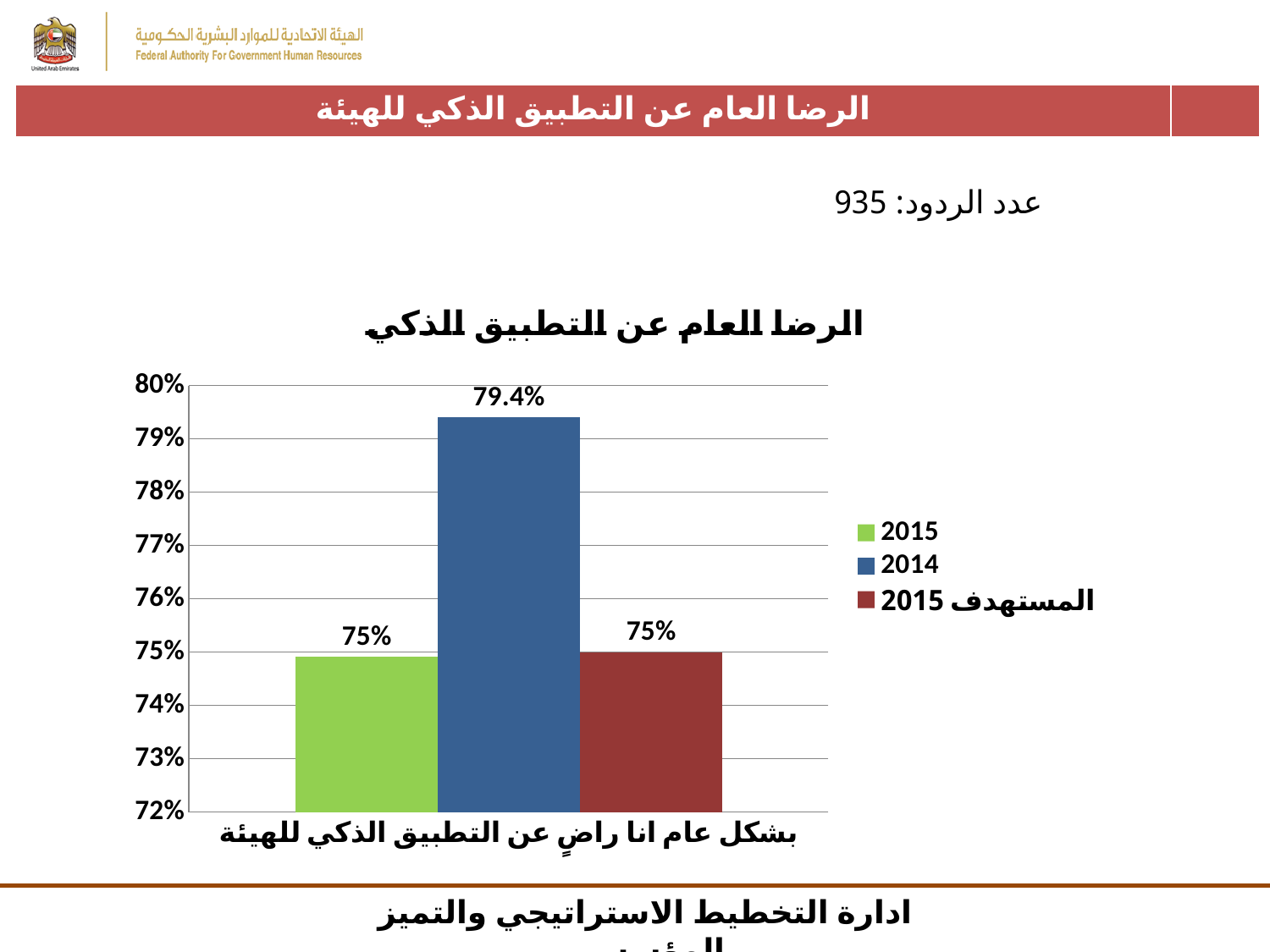
What kind of chart is shown on the slide? bar chart Which series has the highest value? 2014 What is the value for the المستهدف 2015 series? 75% Which is larger, the 2014 value or the المستهدف 2015 value? 2014 Is the value for 2014 greater or less than 78%? greater What is the difference between the 2014 value and the 2015 value? 4.4% How many series does the legend list? 3 What is the value for the 2014 series? 79.4% What is the title of the chart? الرضا العام عن التطبيق الذكي What colour is the bar for the 2014 series? blue What is the value for the 2015 series? 75% Is the value for 2015 greater or less than 77%? less